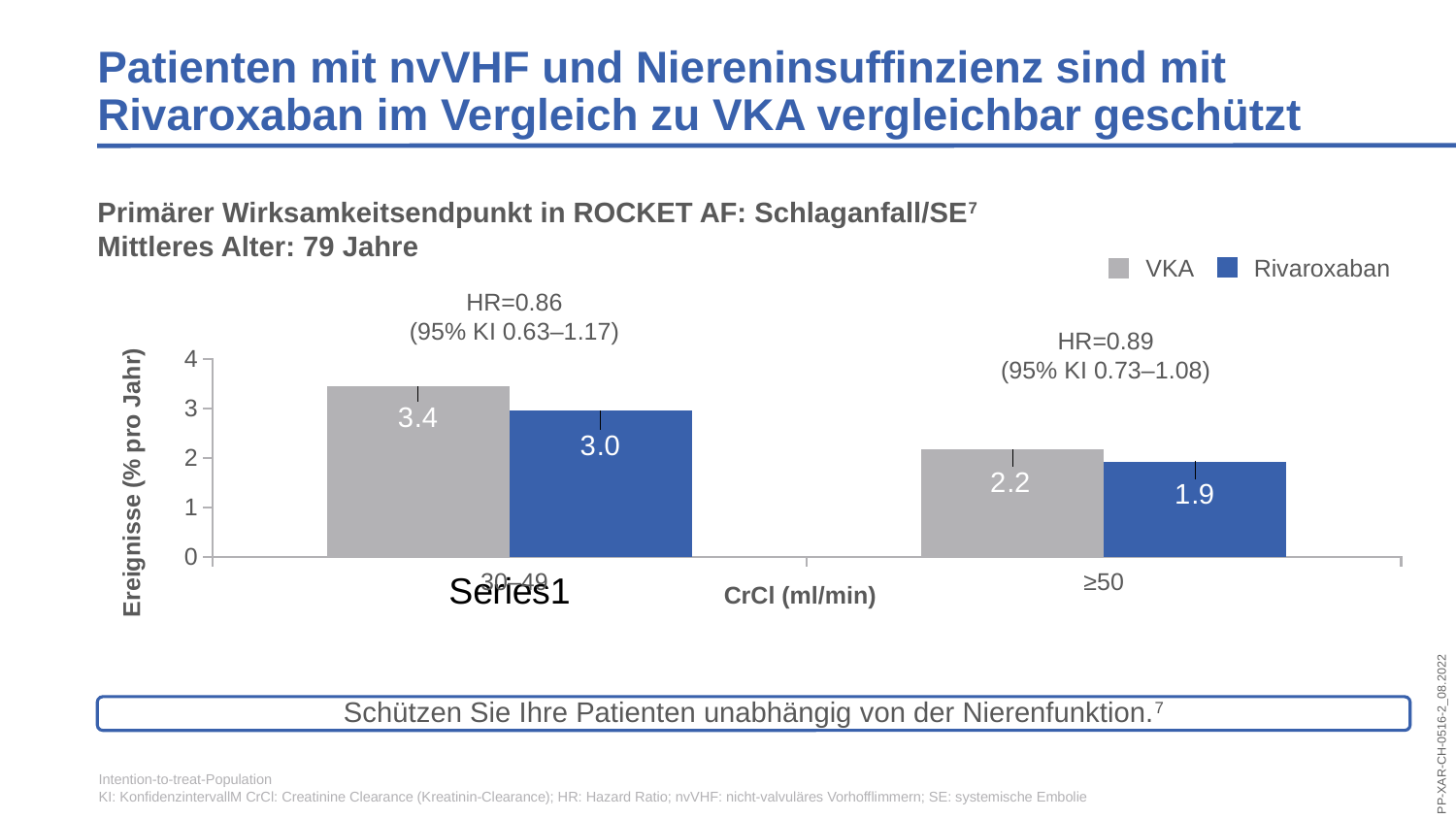
Which bar has the highest value in the chart? VKA in the CrCl 30–49 group (3.4) What is the value for VKA in the CrCl ≥50 group? 2.2 What is the label of the y axis? Ereignisse (% pro Jahr) How many series does the legend list? 2 What is the value for Rivaroxaban in the left group of bars (CrCl 30–49)? 3.0 What is the value for VKA in the left group of bars (CrCl 30–49)? 3.4 What is the difference between the VKA and Rivaroxaban values in the CrCl ≥50 group? 0.3 What is the difference between the VKA and Rivaroxaban values in the CrCl 30–49 group? 0.4 Which bar has the lowest value in the chart? Rivaroxaban in the CrCl ≥50 group (1.9) What kind of chart is shown on the slide? Bar chart In the CrCl ≥50 group, which is larger: the VKA value or the Rivaroxaban value? VKA What is the value for Rivaroxaban in the CrCl ≥50 group? 1.9